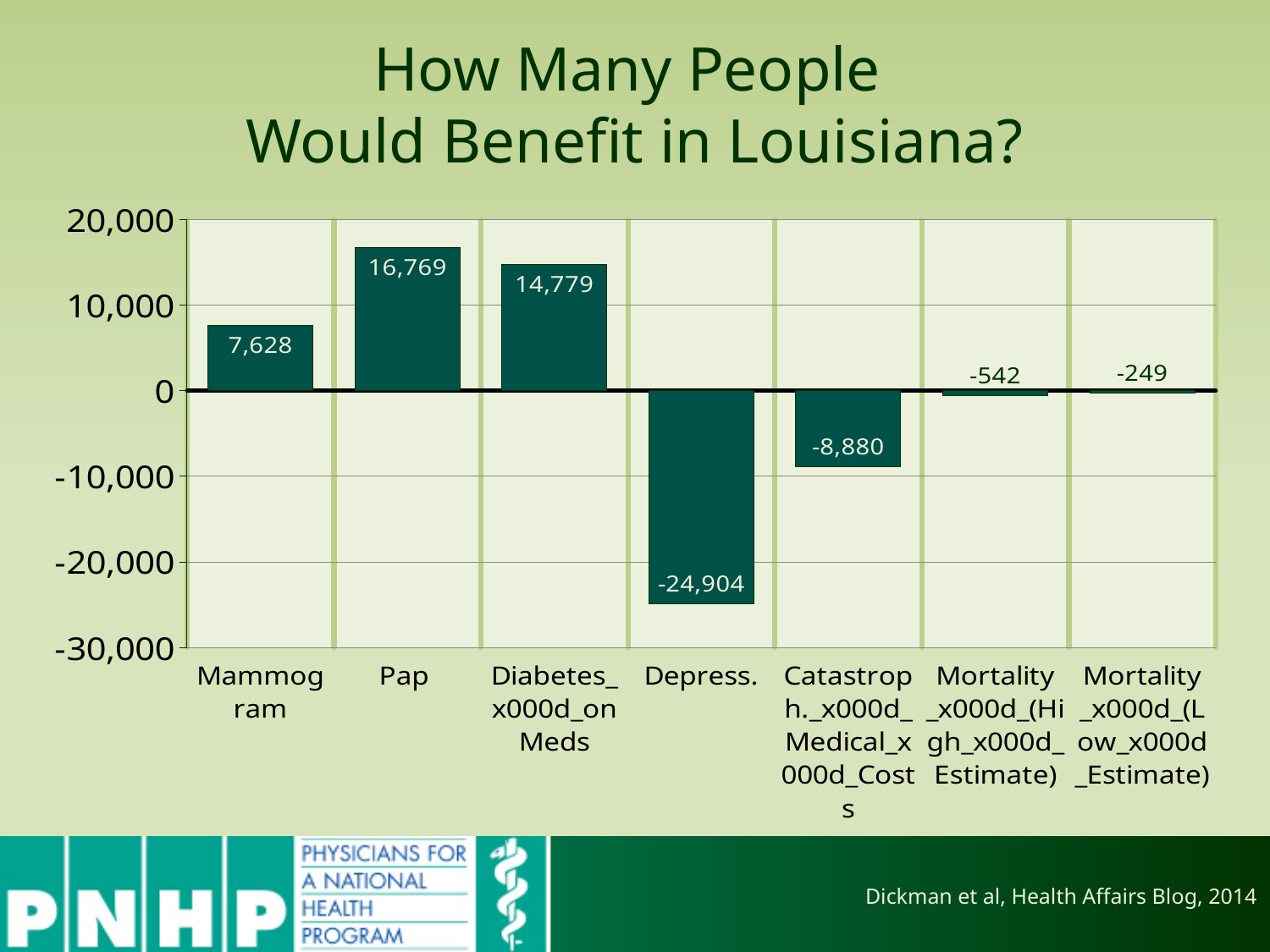
What is the value for Catastrophic Medical Costs? -8,880 What is the difference between the values for Pap and Diabetes on Meds? 1,990 How many categories are shown in the chart? 7 Is the value for Mammogram greater or less than 10,000? less What is the value for Mortality (Low Estimate)? -249 Which category has the lowest value? Depress. Which is larger, the value for Mammogram or the value for Diabetes on Meds? Diabetes on Meds What kind of chart is shown on the slide? bar chart What is the value for Depress.? -24,904 What is the value for Pap? 16,769 What is the value for Mammogram? 7,628 Which category has the highest value? Pap